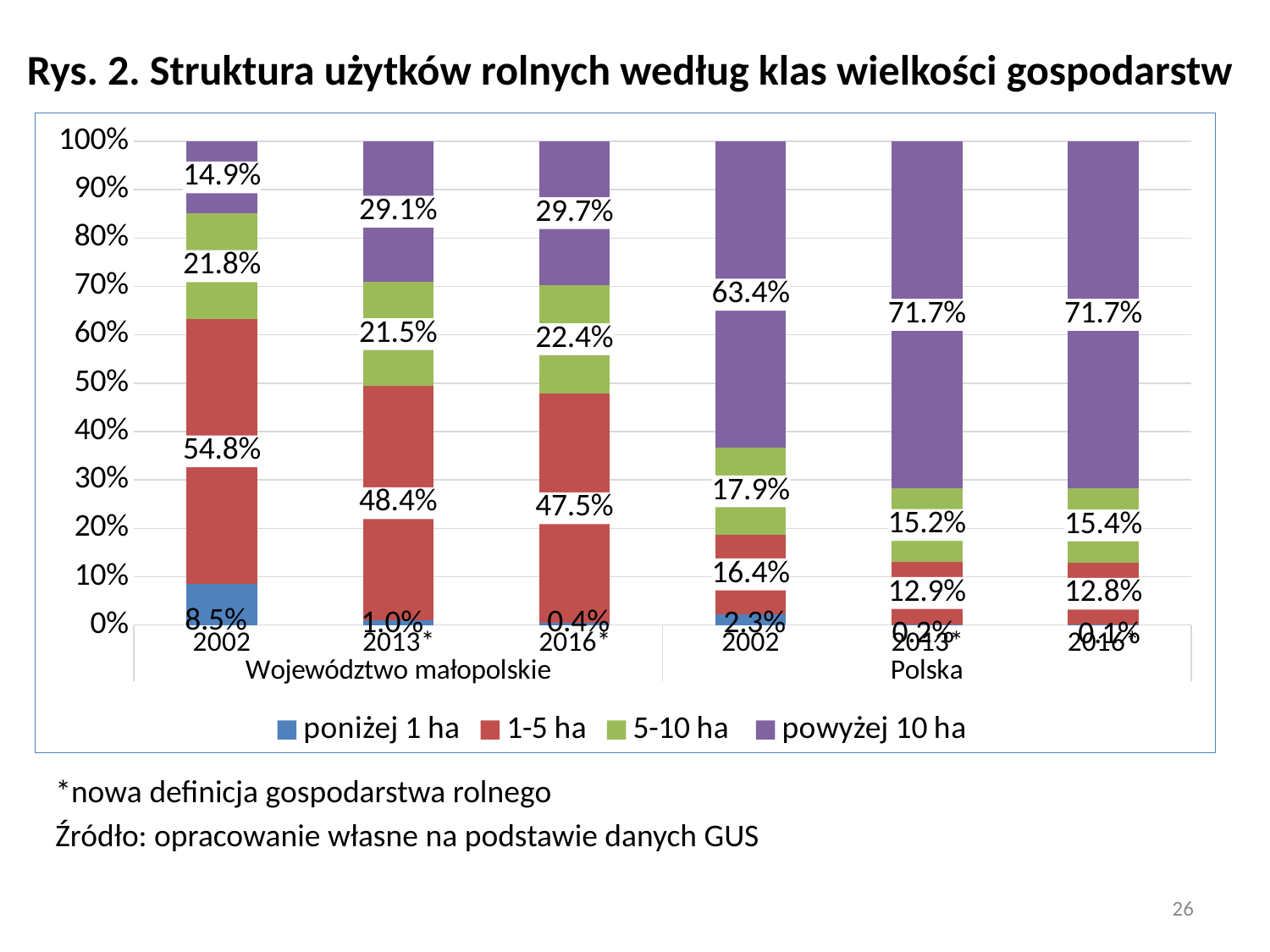
What is the value for the 5-10 ha category in Województwo małopolskie in 2016*? 22.4% Which is larger: the 1-5 ha share in Województwo małopolskie in 2013* or the 1-5 ha share in Polska in 2013*? Województwo małopolskie in 2013* What is the difference between the powyżej 10 ha share in Polska in 2002 and in Województwo małopolskie in 2002? 48.5 percentage points Among the three Województwo małopolskie bars, which year has the highest share for powyżej 10 ha? 2016* Does the share of 1-5 ha farms in Województwo małopolskie rise or fall from 2002 to 2016*? Fall What kind of chart is shown on the slide? Stacked bar chart What share of agricultural land in Polska in 2013* belonged to farms of powyżej 10 ha? 71.7% Among the three Województwo małopolskie bars, which year has the lowest share for poniżej 1 ha? 2016* How many stacked bars are plotted in the chart? 6 What is the value for the poniżej 1 ha category in Polska in 2002? 2.3% How many series does the legend list? 4 What share of agricultural land in Województwo małopolskie in 2002 belonged to farms of 1-5 ha? 54.8%